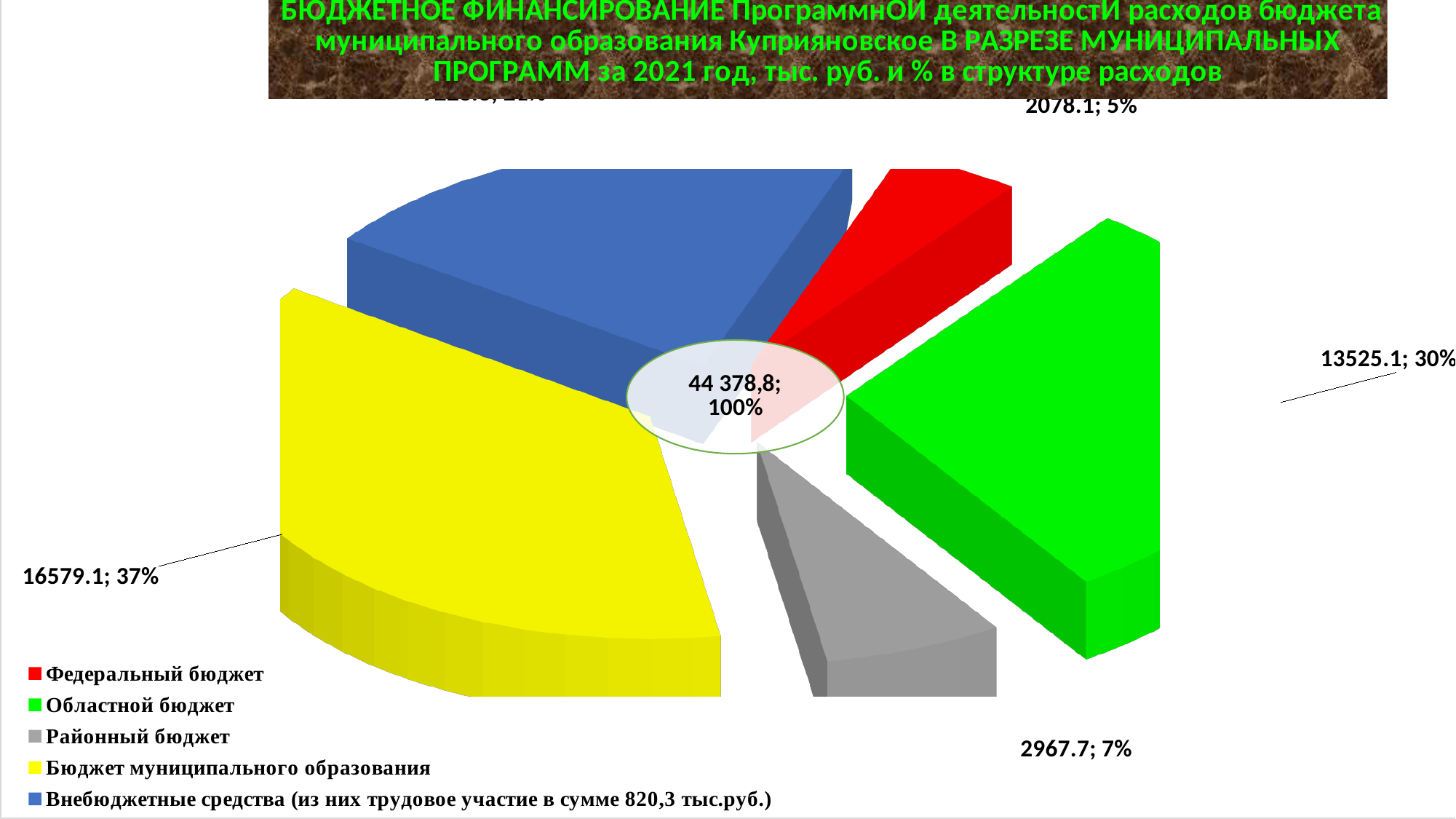
What is the value shown for Федеральный бюджет? 2078.1 What share of the pie does Бюджет муниципального образования represent? 37% How many slices does the pie chart have? 5 What is the value shown for Областной бюджет? 13525.1 How many entries does the legend list? 5 Which is larger: Областной бюджет or Районный бюджет? Областной бюджет What total value is printed in the centre of the pie chart? 44 378,8 Which legend category has the largest slice of the pie? Бюджет муниципального образования What is the difference between the values for Бюджет муниципального образования and Областной бюджет? 3054.0 What share of the pie does Районный бюджет represent? 7% What kind of chart is shown on the slide? pie chart Which legend category has the smallest slice of the pie? Федеральный бюджет